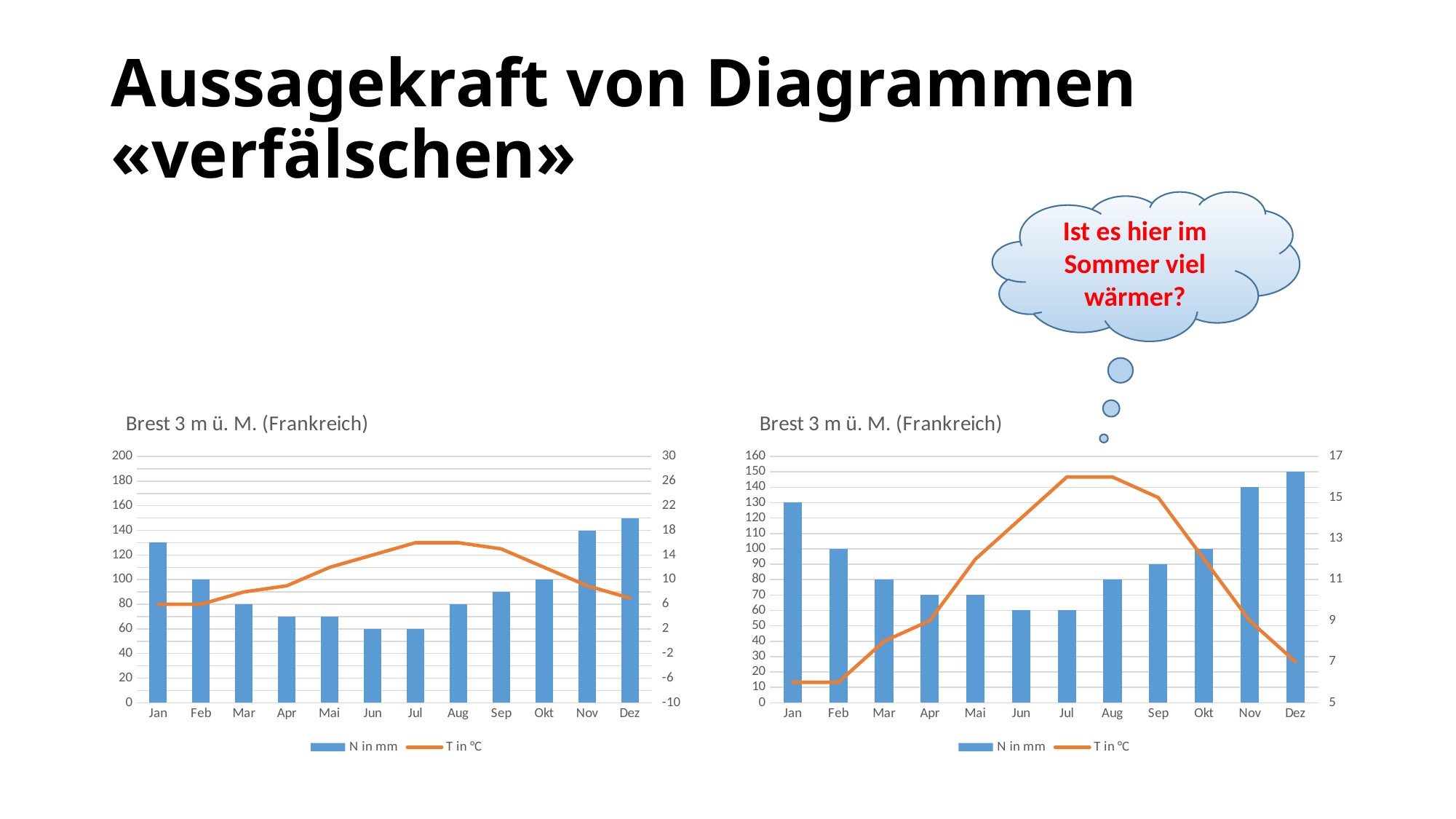
In the right chart, what is the difference in N in mm between Dez and Jan? 20 What kind of chart is the left chart? Combined bar and line chart In the right chart, what is the value of N in mm for Jan? 130 In the left chart, is the T in °C value for Jul greater or less than 10? greater In the right chart, which month has the larger N in mm bar, Nov or Okt? Nov How many series does the legend of the right chart list? 2 In the right chart, which month has the highest N in mm bar? Dez How many months are shown on the x axis of the left chart? 12 In the right chart, does the T in °C line rise or fall from Jan to Jul? rise In the right chart, what is the value of N in mm for Dez? 150 In the right chart, is the T in °C value for Jan greater or less than 7? less In the right chart, what is the value of N in mm for Nov? 140